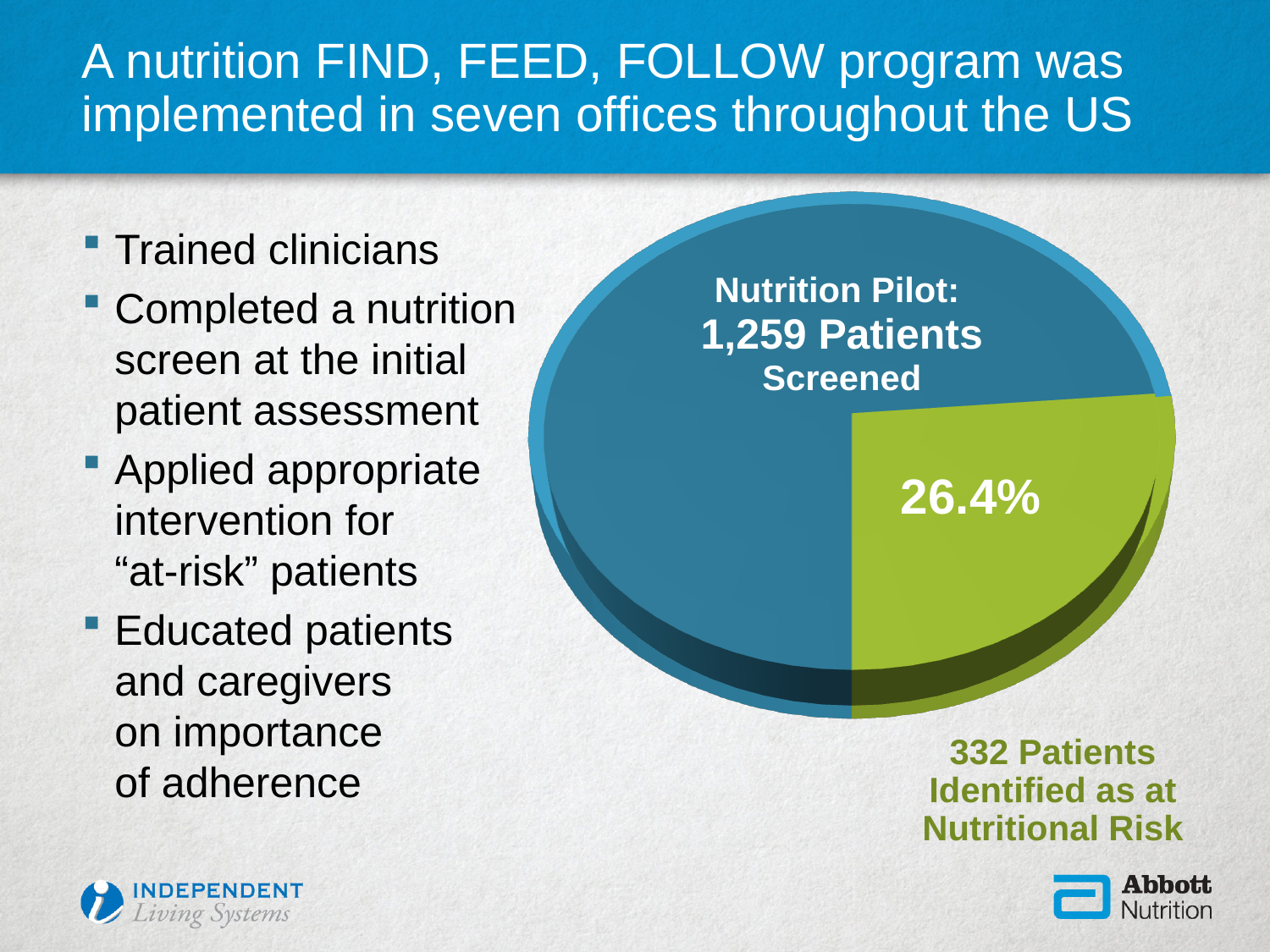
How many patients were screened in the Nutrition Pilot, according to the pie chart? 1,259 How many patients were identified as at nutritional risk, according to the label next to the green slice? 332 Which slice of the pie is the smallest? the green slice (26.4%) Is the share of the green slice greater or less than 50%? less What colour is the slice representing patients identified as at nutritional risk? green What text is printed in the centre of the pie chart? Nutrition Pilot: 1,259 Patients Screened What kind of chart is shown on the slide? pie chart Which slice of the pie is larger, the blue slice or the green slice? the blue slice How many slices does the pie chart have? 2 What share of the pie does the green slice represent? 26.4%